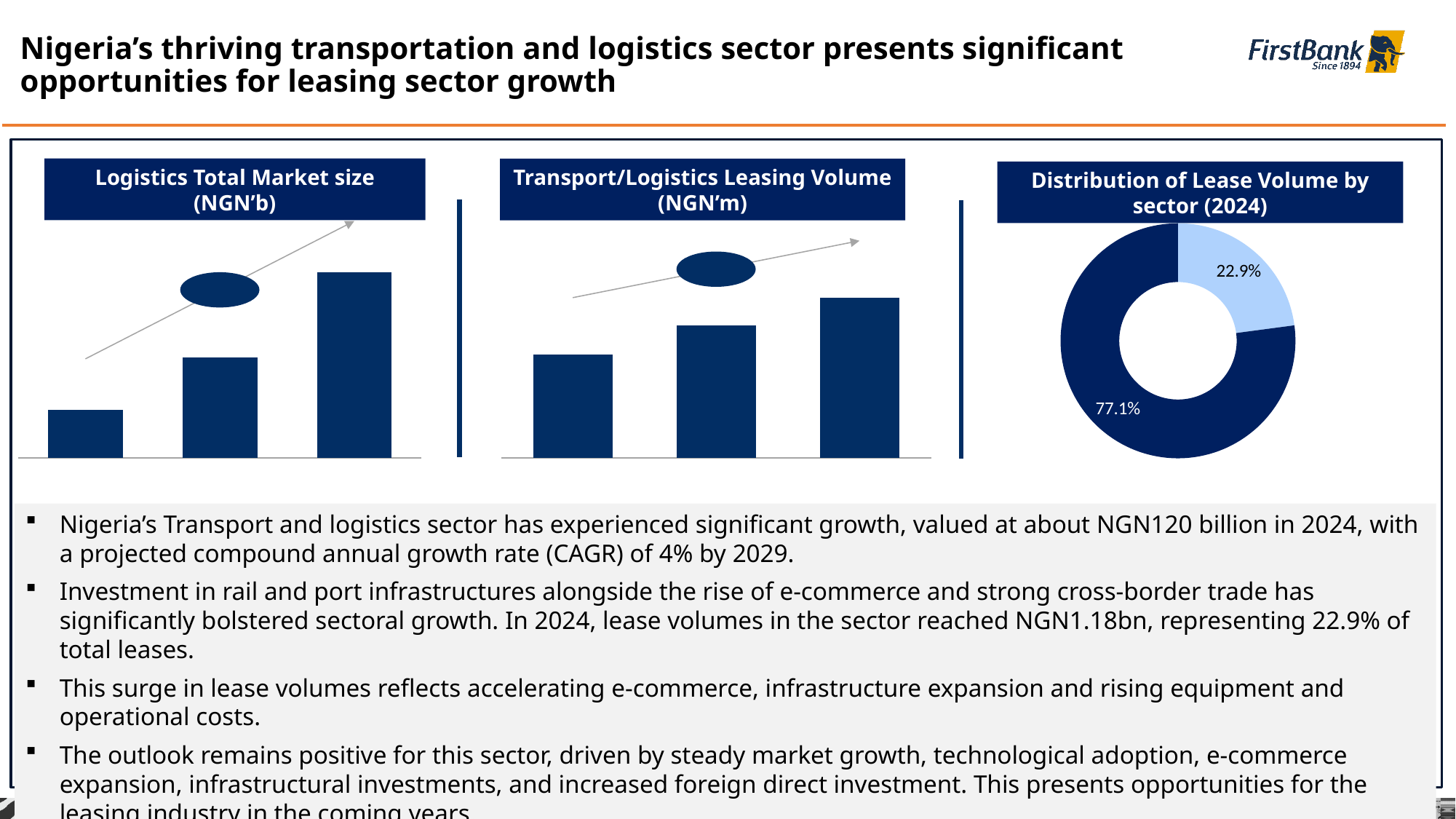
In the 'Distribution of Lease Volume by sector (2024)' chart, what share does the light blue slice represent? 22.9% How many bars are plotted in the 'Transport/Logistics Leasing Volume (NGN'm)' chart? 3 In the 'Logistics Total Market size (NGN'b)' chart, which bar is the tallest: the first, second or third? third What kind of chart is 'Distribution of Lease Volume by sector (2024)'? doughnut chart In the 'Transport/Logistics Leasing Volume (NGN'm)' chart, do the bars rise or fall from left to right? rise In the 'Distribution of Lease Volume by sector (2024)' chart, what share does the dark blue slice represent? 77.1% How many bars are plotted in the 'Logistics Total Market size (NGN'b)' chart? 3 In the 'Transport/Logistics Leasing Volume (NGN'm)' chart, which bar is the shortest: the first, second or third? first In the 'Distribution of Lease Volume by sector (2024)' chart, what is the difference in percentage points between the larger and smaller slices? 54.2 In the 'Logistics Total Market size (NGN'b)' chart, do the bars rise or fall from left to right? rise What kind of chart is the 'Logistics Total Market size (NGN'b)' chart? bar chart What kind of chart is the 'Transport/Logistics Leasing Volume (NGN'm)' chart? bar chart